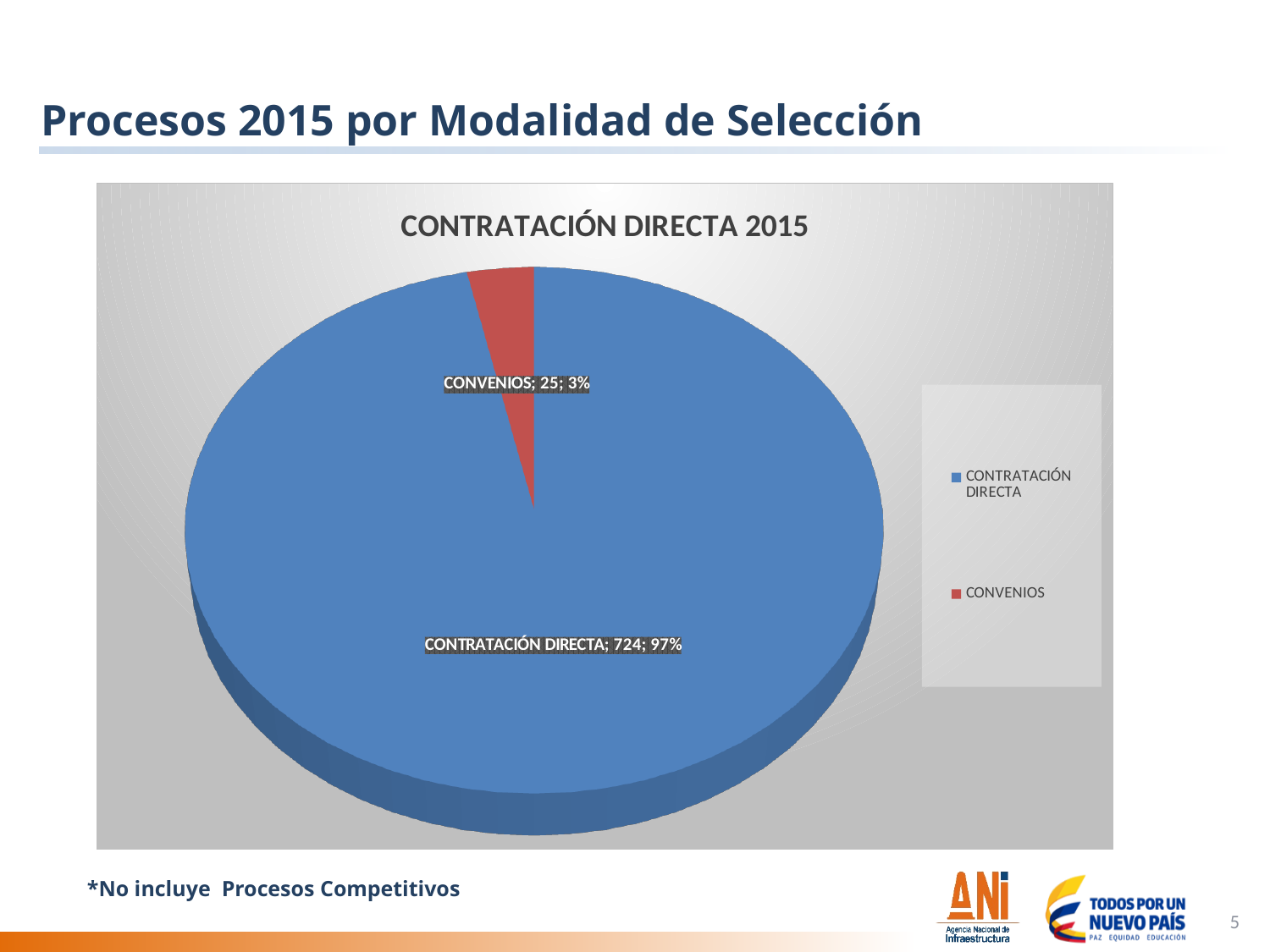
What is the title of the chart? CONTRATACIÓN DIRECTA 2015 What share of the pie does CONTRATACIÓN DIRECTA represent? 97% What kind of chart is shown on the slide? Pie chart What is the value for CONTRATACIÓN DIRECTA in the pie chart? 724 How many categories are shown in the pie chart? 2 What is the difference between the values for CONTRATACIÓN DIRECTA and CONVENIOS? 699 What is the total of the two values shown in the pie chart? 749 Which category has the largest slice in the pie chart? CONTRATACIÓN DIRECTA Which category has the smallest slice in the pie chart? CONVENIOS Which is larger, CONTRATACIÓN DIRECTA or CONVENIOS? CONTRATACIÓN DIRECTA What share of the pie does CONVENIOS represent? 3% What is the value for CONVENIOS in the pie chart? 25